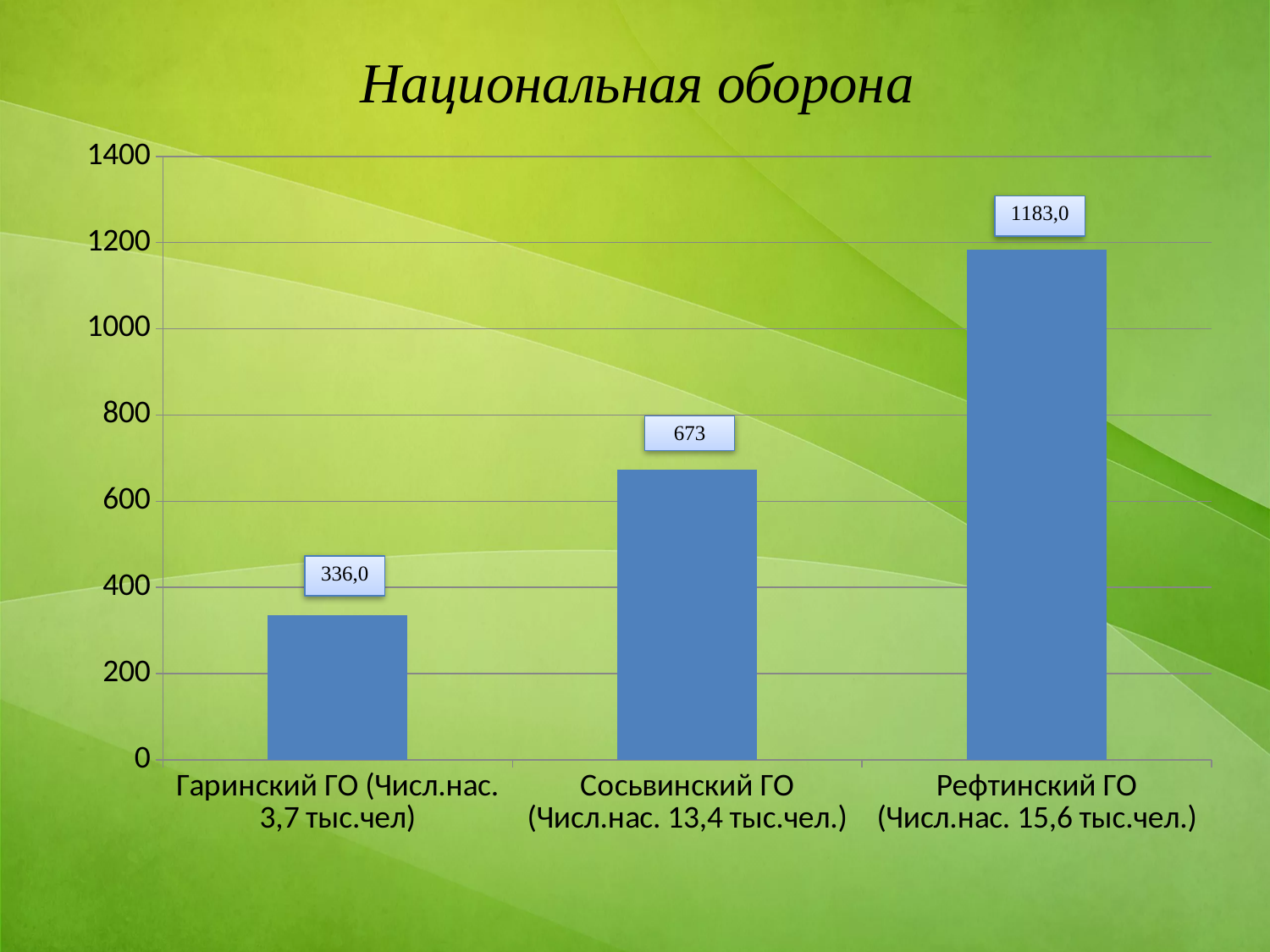
What is the value for Гаринский ГО? 336,0 What is the title of the chart? Национальная оборона What is the value for Рефтинский ГО? 1183,0 Is the value for Рефтинский ГО greater or less than 1000? greater Which is larger, the value for Сосьвинский ГО or the value for Гаринский ГО? Сосьвинский ГО What is the difference between the values for Сосьвинский ГО and Гаринский ГО? 337 What is the difference between the values for Рефтинский ГО and Сосьвинский ГО? 510 What kind of chart is shown on the slide? bar chart What is the value for Сосьвинский ГО? 673 Which category has the highest value? Рефтинский ГО How many categories are shown in the chart? 3 Which category has the lowest value? Гаринский ГО